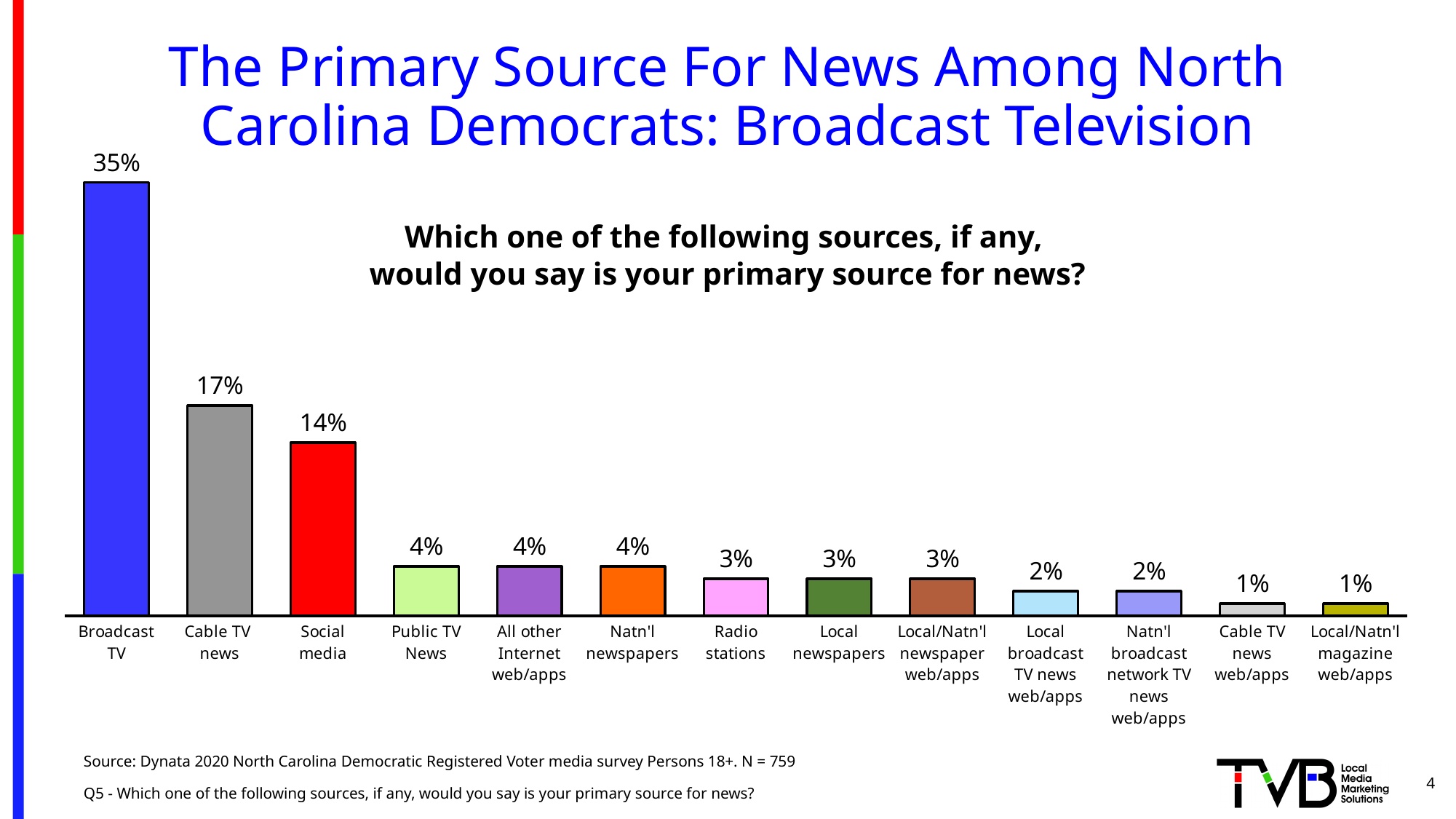
What is the value shown for Social media? 14% What is the value shown for Natn'l broadcast network TV news web/apps? 2% What is the difference between the values for Broadcast TV and Cable TV news? 18% What kind of chart is shown on the slide? Bar chart Which is larger, the value for Public TV News or the value for Local newspapers? Public TV News What is the value shown for Radio stations? 3% Do the values rise or fall moving from left to right along the x axis? Fall How many sources (categories) are shown in the chart? 13 What colour is the bar for Social media? Red What percentage of North Carolina Democrats say Broadcast TV is their primary source for news? 35% What is the difference between the values for Cable TV news and Social media? 3% Which source has the highest value in the chart? Broadcast TV